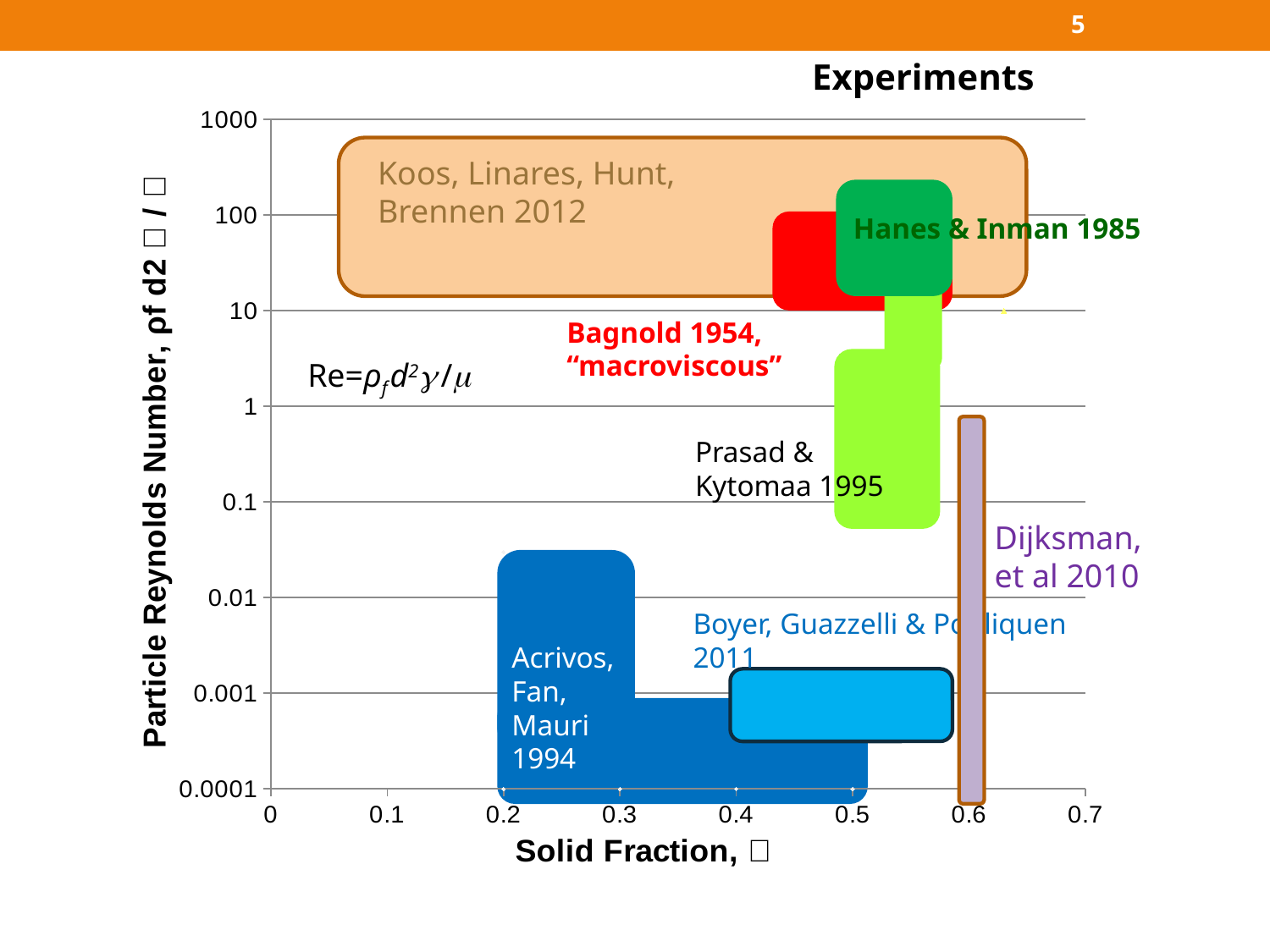
Which region lies at higher Particle Reynolds Numbers, Bagnold 1954 "macroviscous" or Boyer, Guazzelli & Pouliquen 2011? Bagnold 1954 "macroviscous" Which region lies at a higher Solid Fraction, Dijksman, et al 2010 or Acrivos, Fan, Mauri 1994? Dijksman, et al 2010 What is the label of the x axis of the chart? Solid Fraction What is the title of the chart? Experiments Which region lies at higher Particle Reynolds Numbers, Prasad & Kytomaa 1995 or Acrivos, Fan, Mauri 1994? Prasad & Kytomaa 1995 Is the Solid Fraction of the Acrivos, Fan, Mauri 1994 region greater or less than 0.1? greater How many labelled experimental regions are drawn on the chart? 7 Is the Solid Fraction of the Dijksman, et al 2010 region greater or less than 0.5? greater Is the Particle Reynolds Number of the Acrivos, Fan, Mauri 1994 region greater or less than 0.1? less Which region spans the widest range of Solid Fraction on the chart? Koos, Linares, Hunt, Brennen 2012 Which labelled region reaches the highest Particle Reynolds Number on the chart? Koos, Linares, Hunt, Brennen 2012